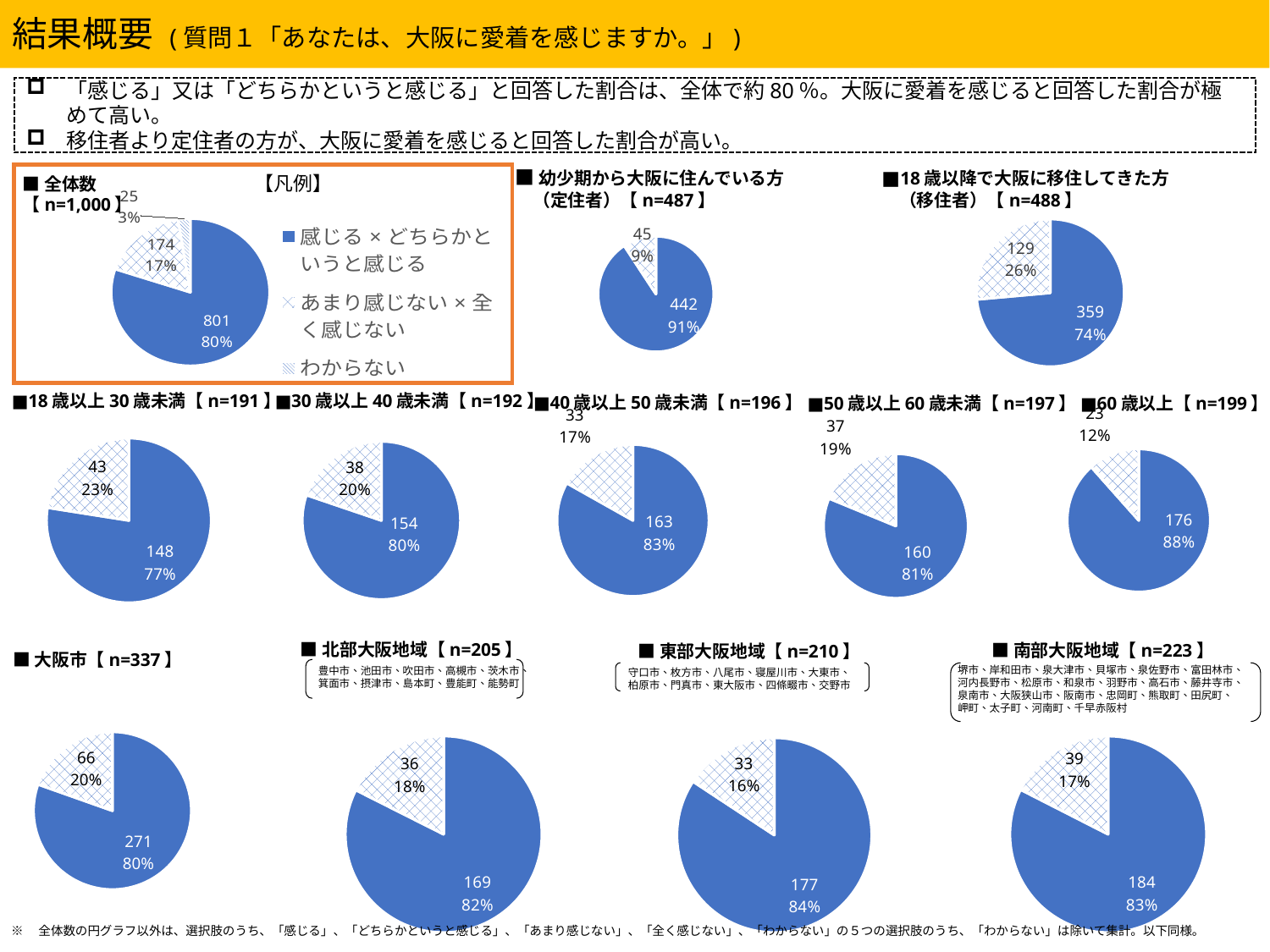
Among the five age-group pie charts (18歳以上30歳未満 to 60歳以上), which has the lowest 感じる×どちらかというと感じる percentage? 18歳以上30歳未満【n=191】 Among the five age-group pie charts (18歳以上30歳未満 to 60歳以上), which has the highest 感じる×どちらかというと感じる percentage? 60歳以上【n=199】 In the 18歳以降で大阪に移住してきた方（移住者）【n=488】 pie chart, what is the count for あまり感じない×全く感じない? 129 Which has the larger 感じる×どちらかというと感じる share: the 定住者【n=487】 chart or the 移住者【n=488】 chart? 定住者【n=487】 In the 幼少期から大阪に住んでいる方（定住者）【n=487】 pie chart, what percentage is the 感じる×どちらかというと感じる slice? 91% How many entries does the legend (凡例) list? 3 In the 全体数【n=1,000】 pie chart, what share does わからない have? 3% In the 全体数【n=1,000】 pie chart, what is the count for 感じる×どちらかというと感じる? 801 In the 全体数【n=1,000】 pie chart, what share does あまり感じない×全く感じない have? 17% In the 南部大阪地域【n=223】 pie chart, what is the count for 感じる×どちらかというと感じる? 184 In the 東部大阪地域【n=210】 pie chart, what is the difference between the 感じる×どちらかというと感じる count and the あまり感じない×全く感じない count? 144 What kind of chart is used for the 全体数【n=1,000】 data? pie chart